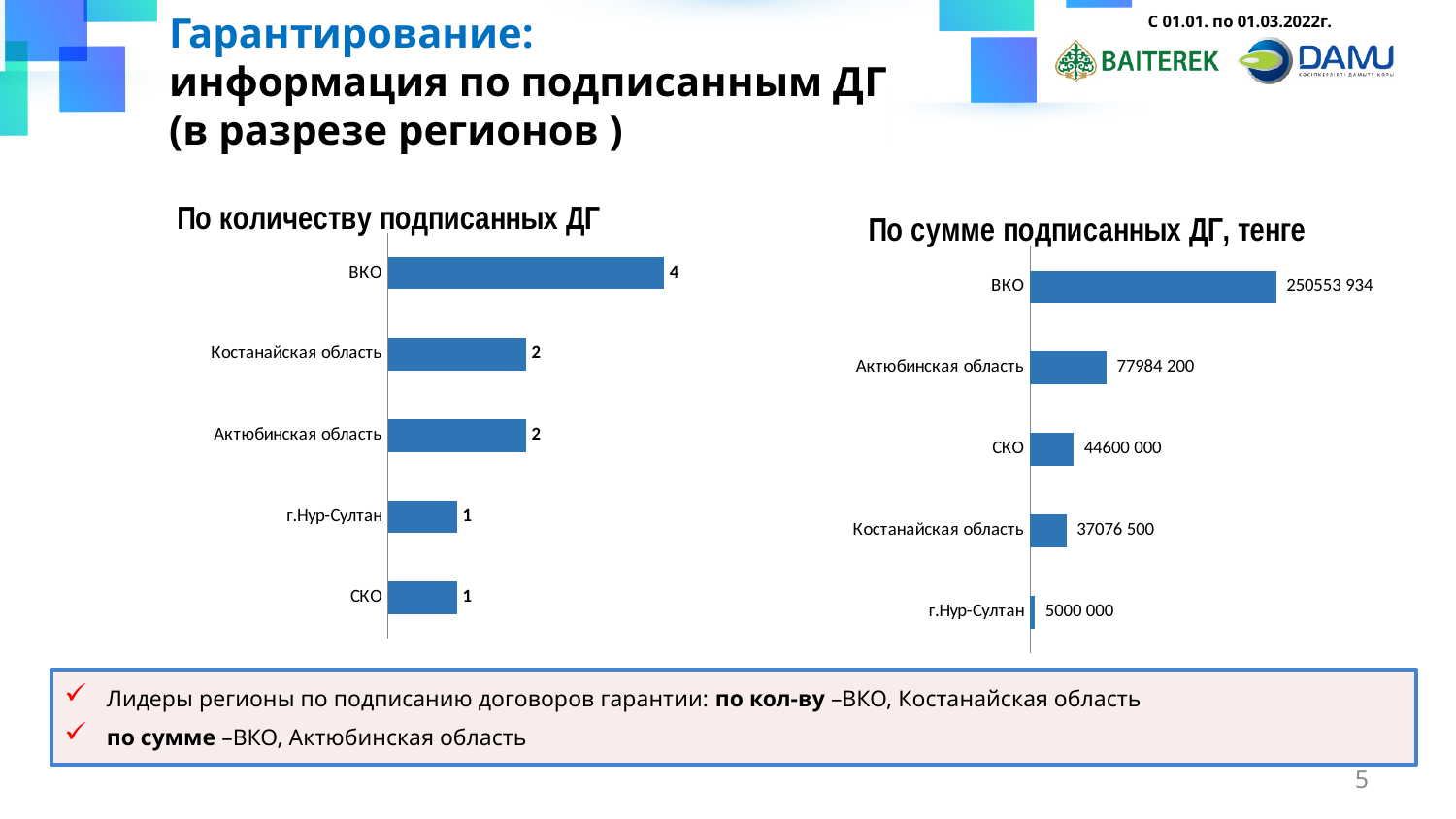
In the chart 'По сумме подписанных ДГ, тенге', which region has the lowest value? г.Нур-Султан In the chart 'По сумме подписанных ДГ, тенге', what is the value for СКО? 44600 000 What type of chart is 'По сумме подписанных ДГ, тенге'? Bar chart In the chart 'По сумме подписанных ДГ, тенге', which region has the highest value? ВКО How many charts are shown on the slide? 2 In the chart 'По количеству подписанных ДГ', what is the difference between ВКО and Костанайская область? 2 In the chart 'По количеству подписанных ДГ', what is the value for ВКО? 4 In the chart 'По количеству подписанных ДГ', what is the value for г.Нур-Султан? 1 In the chart 'По количеству подписанных ДГ', which region has the highest value? ВКО In the chart 'По количеству подписанных ДГ', how many regions are shown? 5 In the chart 'По сумме подписанных ДГ, тенге', which is larger: СКО or Костанайская область? СКО In the chart 'По сумме подписанных ДГ, тенге', what is the value for Актюбинская область? 77984 200